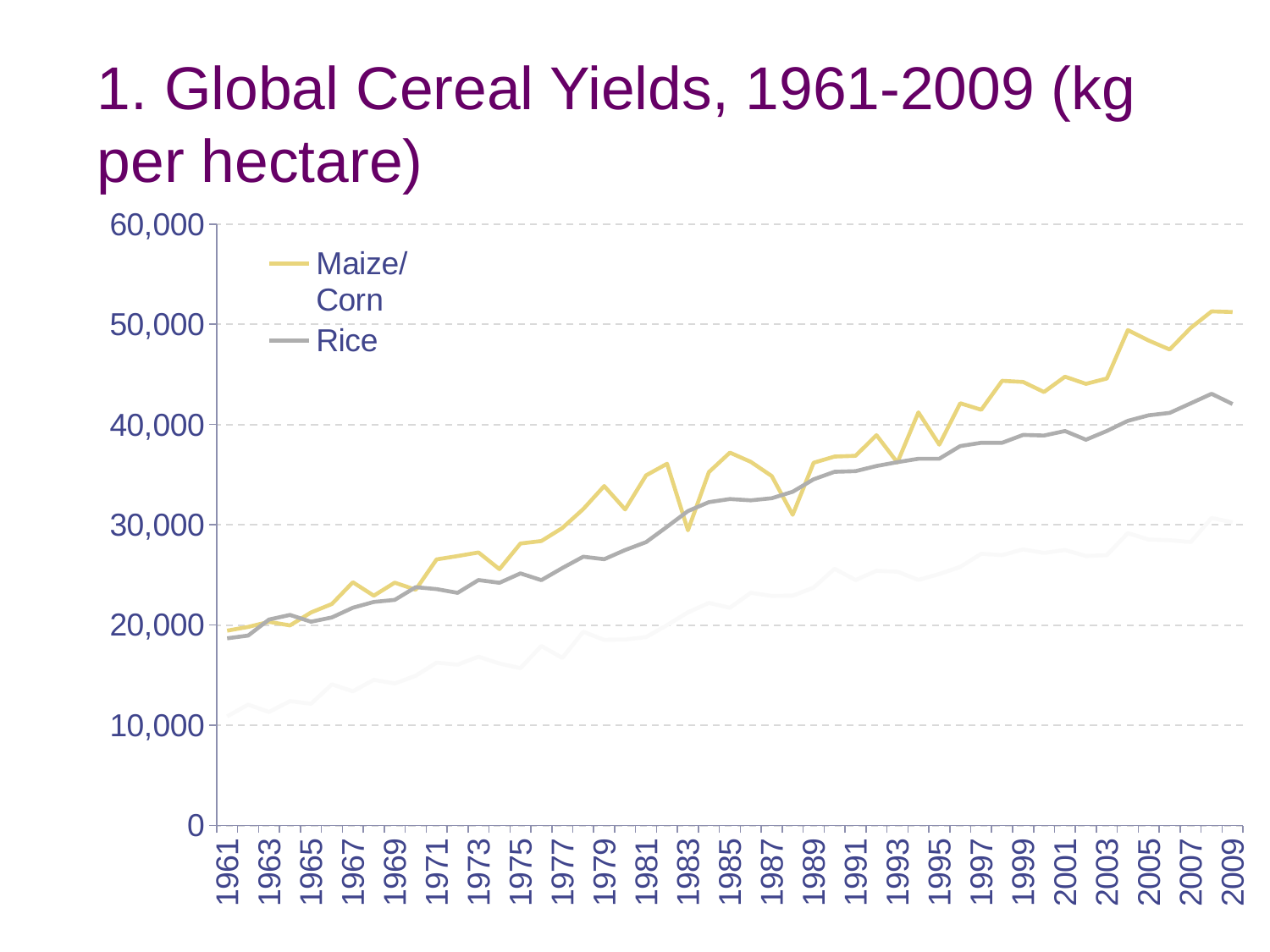
Is the Maize/Corn value for 2009 greater or less than 50,000? greater Does the Rice yield generally rise or fall from 1961 to 2009? rise In 1983, which series has the higher value, Maize/Corn or Rice? Rice Is the Rice value for 2009 greater or less than 40,000? greater What kind of chart is shown on the slide? line chart Is the Maize/Corn value for 1985 greater or less than 30,000? greater What is the title of the chart? 1. Global Cereal Yields, 1961-2009 (kg per hectare) In 2009, which series has the higher value, Maize/Corn or Rice? Maize/Corn What colour is the Maize/Corn line? yellow How many series does the legend list? 2 Does the Maize/Corn yield generally rise or fall from 1961 to 2009? rise